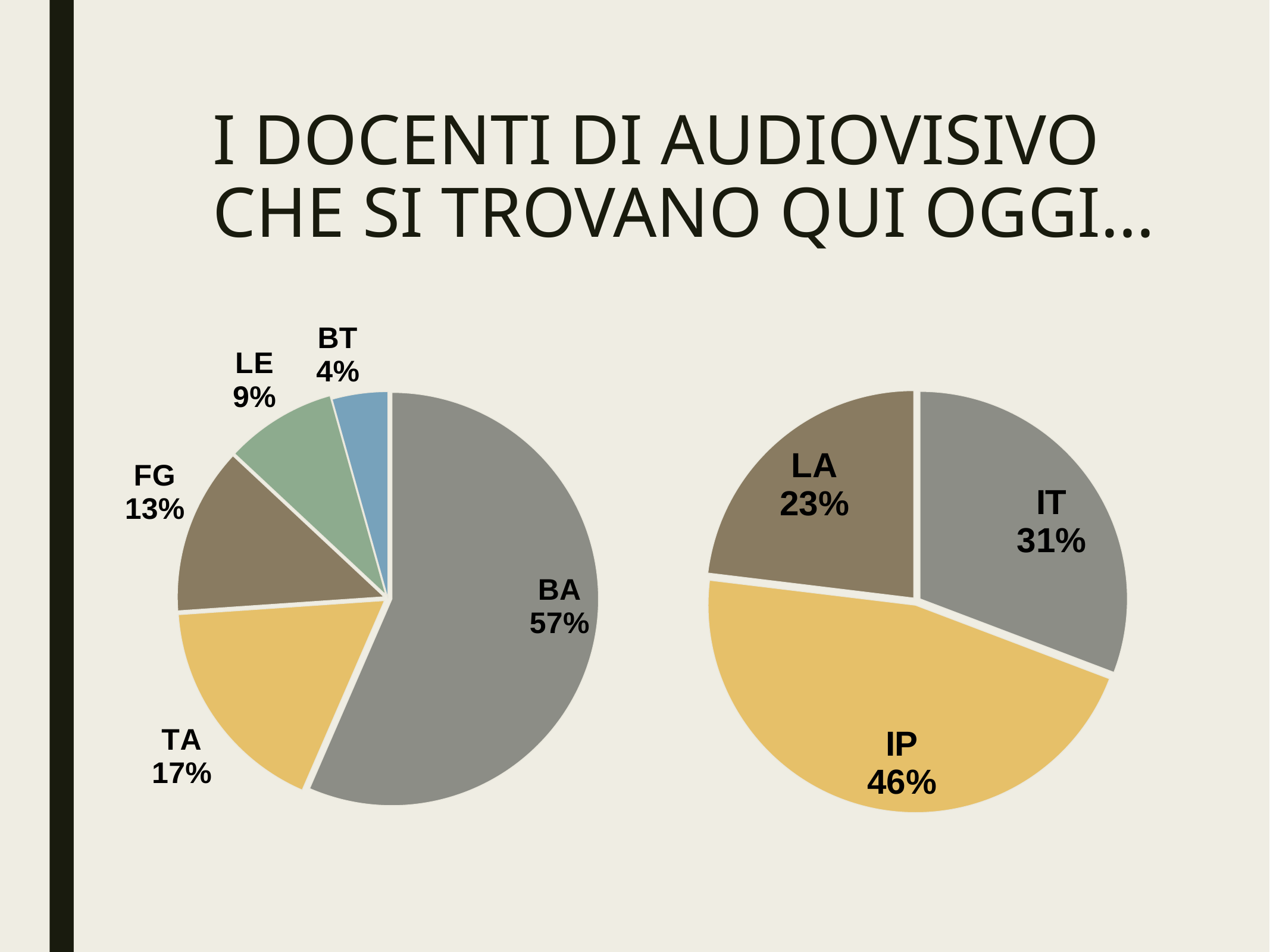
In the right pie chart, what is the difference between the shares of IP and IT? 15% In the left pie chart, which category has the largest slice? BA In the right pie chart, what share does LA have? 23% In the right pie chart, which category has the smallest slice? LA In the right pie chart, what share does IP have? 46% In the left pie chart, which category has the smallest slice? BT In the right pie chart, which is larger, IT or LA? IT In the left pie chart, what share does BA have? 57% In the left pie chart, what is the difference between the shares of TA and LE? 8% What kind of chart is the right chart? Pie chart In the left pie chart, what share does FG have? 13% How many slices does the left pie chart have? 5